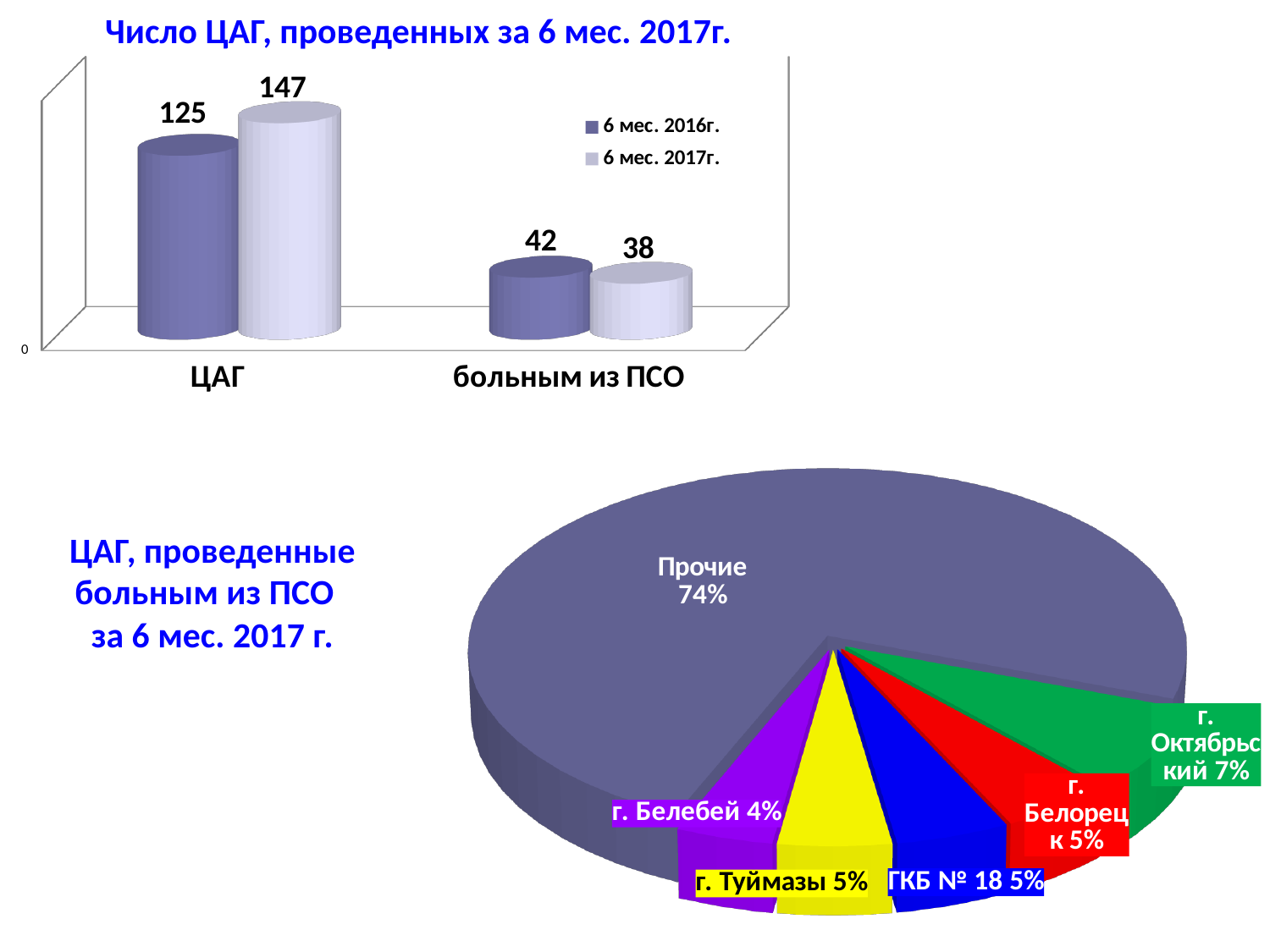
In the bar chart 'Число ЦАГ, проведенных за 6 мес. 2017г.', how many series does the legend list? 2 In the pie chart 'ЦАГ, проведенные больным из ПСО за 6 мес. 2017 г.', what share does 'г. Октябрьский' have? 7% What kind of chart is the top chart on the slide? Bar chart In the bar chart 'Число ЦАГ, проведенных за 6 мес. 2017г.', what is the value for 'больным из ПСО' in the series '6 мес. 2016г.'? 42 In the pie chart 'ЦАГ, проведенные больным из ПСО за 6 мес. 2017 г.', which slice is the smallest? г. Белебей In the pie chart 'ЦАГ, проведенные больным из ПСО за 6 мес. 2017 г.', how many slices are there? 6 In the bar chart 'Число ЦАГ, проведенных за 6 мес. 2017г.', how many categories are shown on the x axis? 2 In the bar chart 'Число ЦАГ, проведенных за 6 мес. 2017г.', what is the difference between the 2017 and 2016 values for ЦАГ? 22 In the pie chart 'ЦАГ, проведенные больным из ПСО за 6 мес. 2017 г.', what share does 'Прочие' have? 74% In the pie chart 'ЦАГ, проведенные больным из ПСО за 6 мес. 2017 г.', what colour is the 'г. Туймазы' slice? Yellow In the bar chart 'Число ЦАГ, проведенных за 6 мес. 2017г.', what is the value for ЦАГ in the series '6 мес. 2017г.'? 147 In the bar chart 'Число ЦАГ, проведенных за 6 мес. 2017г.', which series has the larger value for 'больным из ПСО'? 6 мес. 2016г.